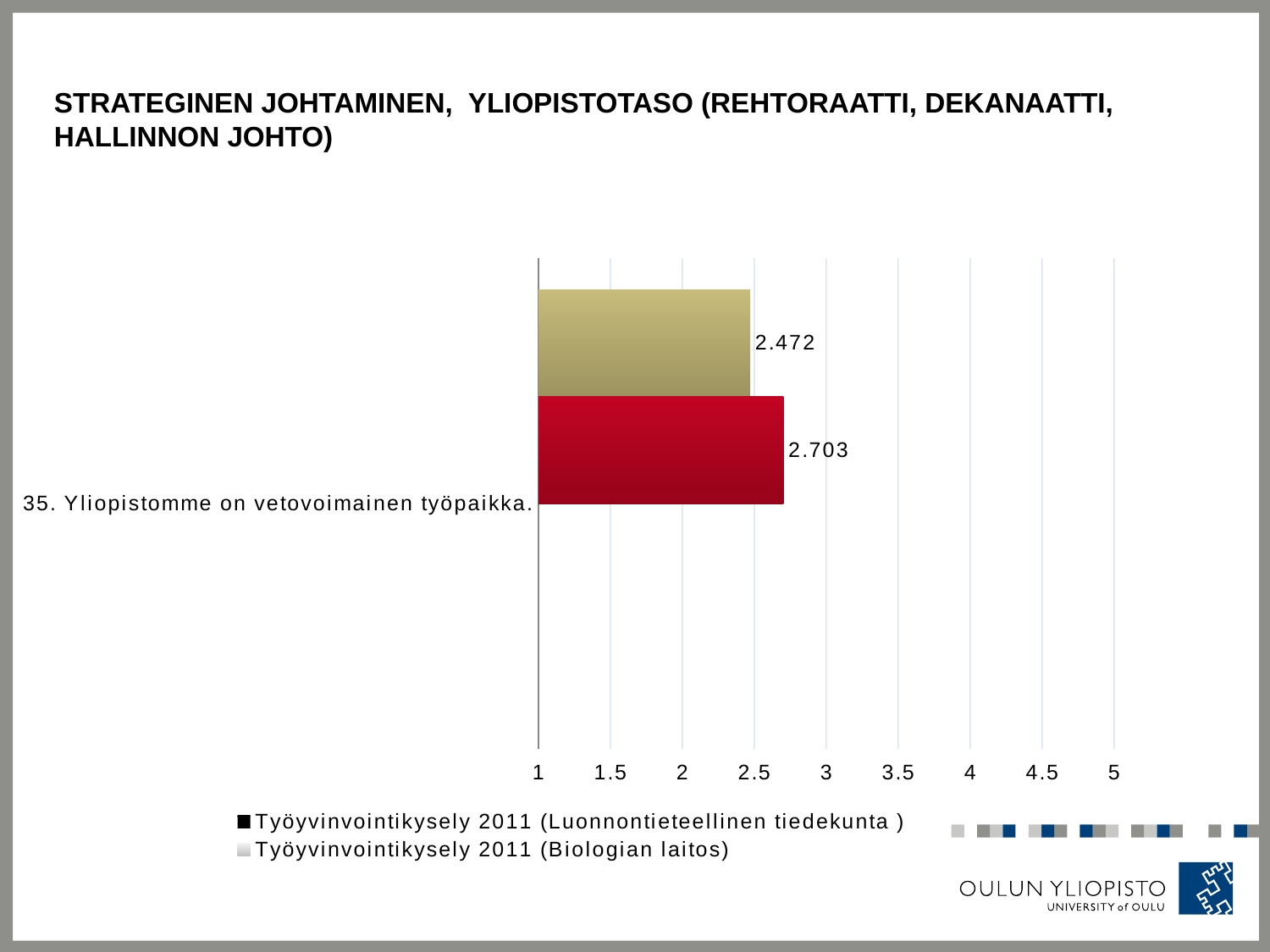
What is the category label shown on the chart? 35. Yliopistomme on vetovoimainen työpaikka. What is the difference between the red bar's value (2.703) and the gold bar's value (2.472)? 0.231 What value is labelled on the gold (top) bar? 2.472 Which bar is longer, the red bar or the gold bar? The red bar What is the highest value shown on the x axis? 5 How many series does the legend list? 2 What value is labelled on the red bar? 2.703 Is the value of the gold bar greater or less than 2? greater What is the lowest value shown on the x axis? 1 Is the value of the red bar greater or less than 3? less How many categories (statements) are plotted on the chart? 1 What kind of chart is shown on the slide? Bar chart